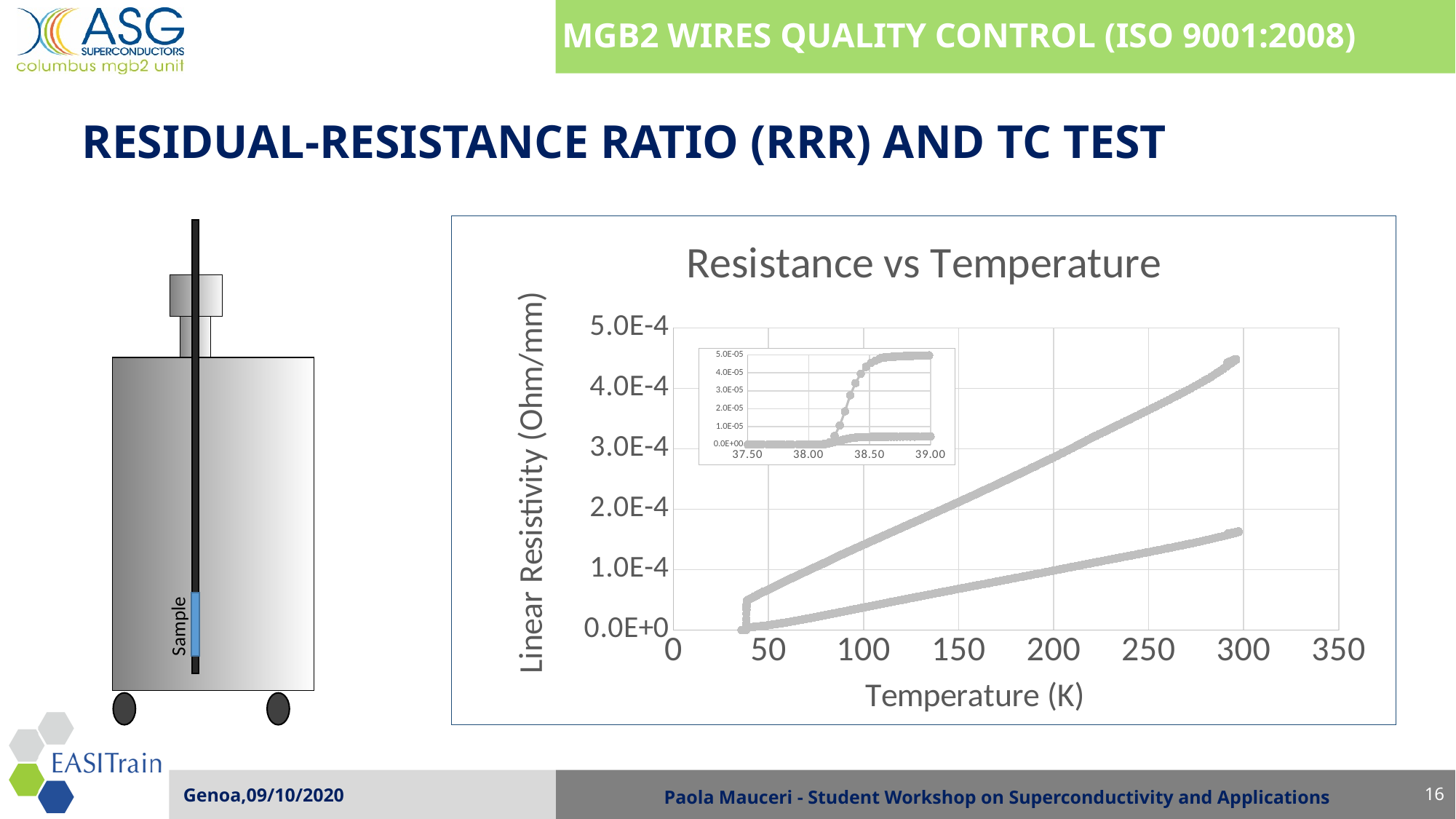
In the Resistance vs Temperature chart, is the value of the upper curve at about 300 K greater or less than 4.0E-4? greater In the inset chart of the Resistance vs Temperature chart, what is the lowest temperature tick shown on its x axis? 37.50 What is the title of the chart on the slide? Resistance vs Temperature In the Resistance vs Temperature chart, is the value of the lower curve at about 300 K greater or less than 2.0E-4? less In the Resistance vs Temperature chart, at 200 K, which curve has the larger linear resistivity, the upper curve or the lower curve? the upper curve In the inset chart of the Resistance vs Temperature chart, what is the highest value tick shown on its y axis? 5.0E-05 In the Resistance vs Temperature chart, do the plotted values rise or fall as temperature increases? rise What is the highest tick value shown on the x axis of the Resistance vs Temperature chart? 350 What is the label of the x axis of the Resistance vs Temperature chart? Temperature (K) How many data series (curves) are plotted in the main Resistance vs Temperature chart? 2 What kind of chart is the Resistance vs Temperature chart? scatter chart